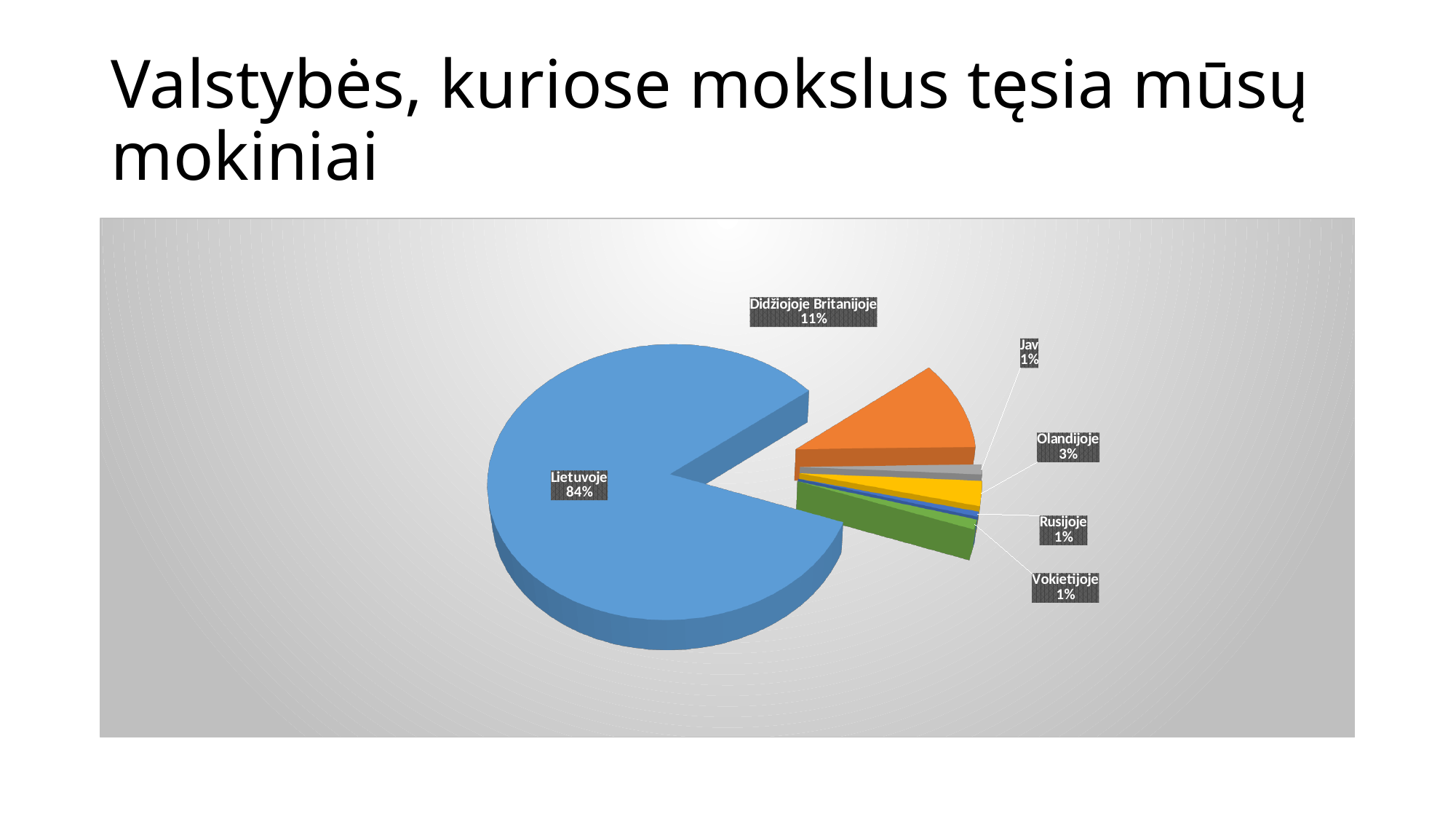
Which category has the largest slice of the pie? Lietuvoje What kind of chart is shown on the slide? pie chart What is the difference between the shares of Didžiojoje Britanijoje and Olandijoje? 8% What share of the pie does Lietuvoje have? 84% Which is larger, the share for Olandijoje or the share for Jav? Olandijoje What is the value shown for Vokietijoje? 1% How many slices does the pie chart have? 6 What colour is the slice for Lietuvoje? blue What share of the pie does Didžiojoje Britanijoje have? 11% What share of the pie does Olandijoje have? 3% What is the difference between the shares of Lietuvoje and Didžiojoje Britanijoje? 73% What is the value shown for Rusijoje? 1%